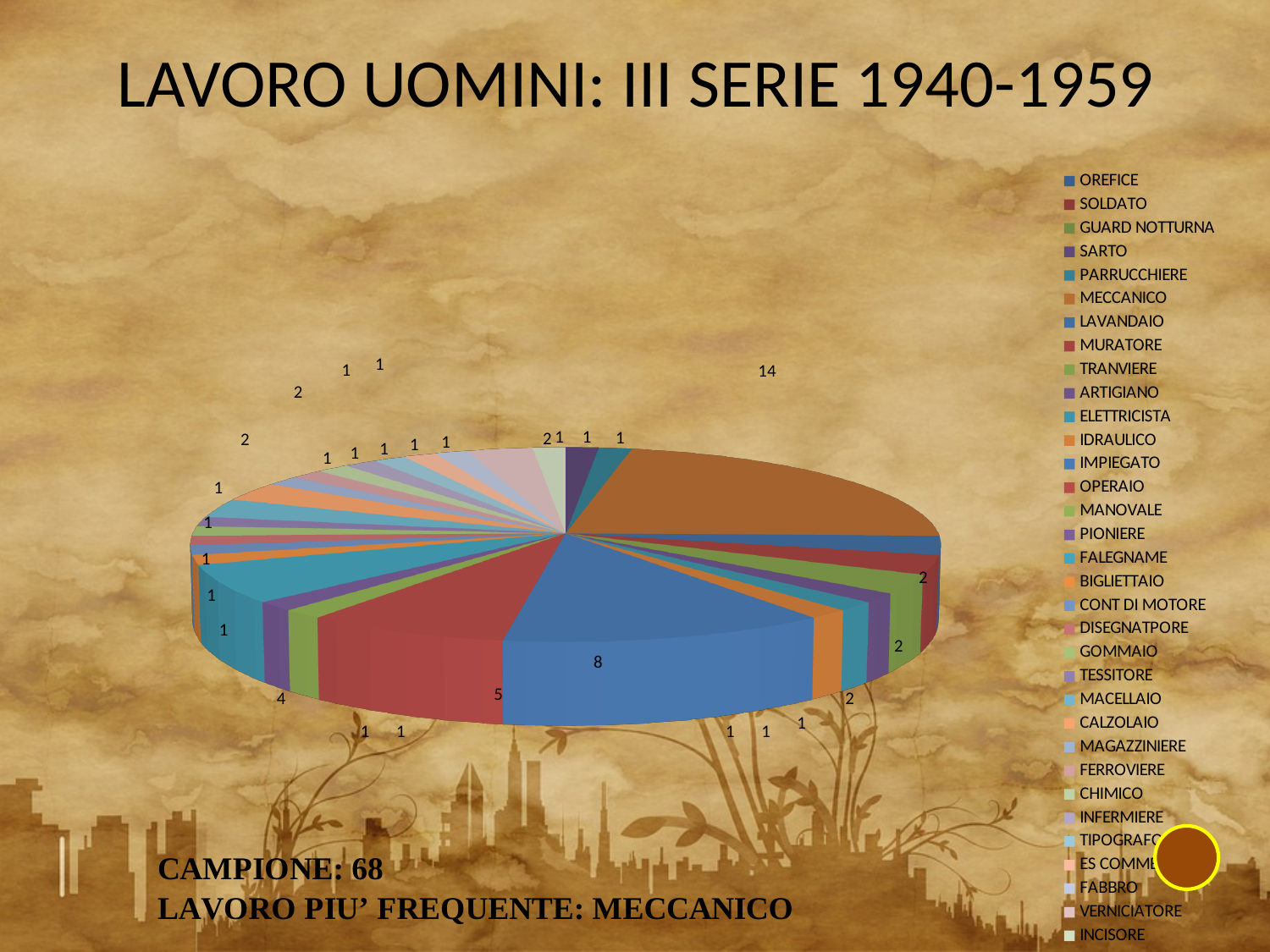
What is the difference between the values for MECCANICO and IMPIEGATO? 6 What is the value shown for IMPIEGATO? 8 What is the largest data label value shown on the pie chart? 14 What is the value shown for MECCANICO? 14 What is the difference between the values for IMPIEGATO and OPERAIO? 3 What sample size (CAMPIONE) is stated on the slide? 68 Which category has the largest slice in the pie chart? MECCANICO What type of chart is shown on the slide? pie chart How many categories does the legend list? 33 What is the value shown for OPERAIO? 5 Which is larger, the value for MECCANICO or the value for IMPIEGATO? MECCANICO What is the title of the chart on the slide? LAVORO UOMINI: III SERIE 1940-1959